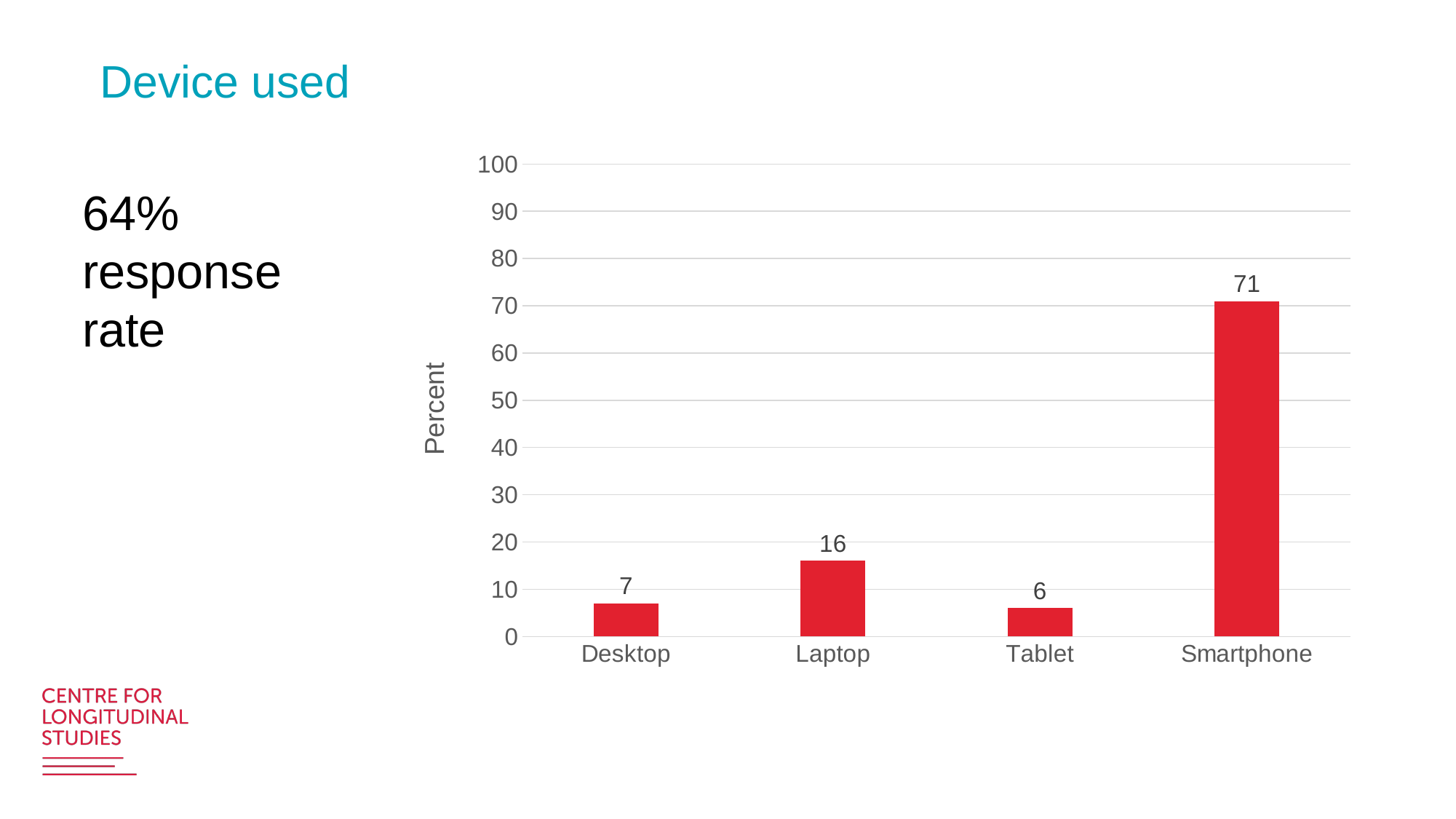
What is the label on the vertical axis? Percent What is the value for Desktop? 7 Which device has the highest value? Smartphone What kind of chart is shown on the slide? Bar chart What is the difference between the values for Smartphone and Laptop? 55 How many device categories are shown on the x axis? 4 What is the value for Tablet? 6 What is the value for Laptop? 16 Which device has the lowest value? Tablet Which is larger, the value for Laptop or the value for Desktop? Laptop Is the value for Smartphone greater or less than 50? greater What is the value for Smartphone? 71